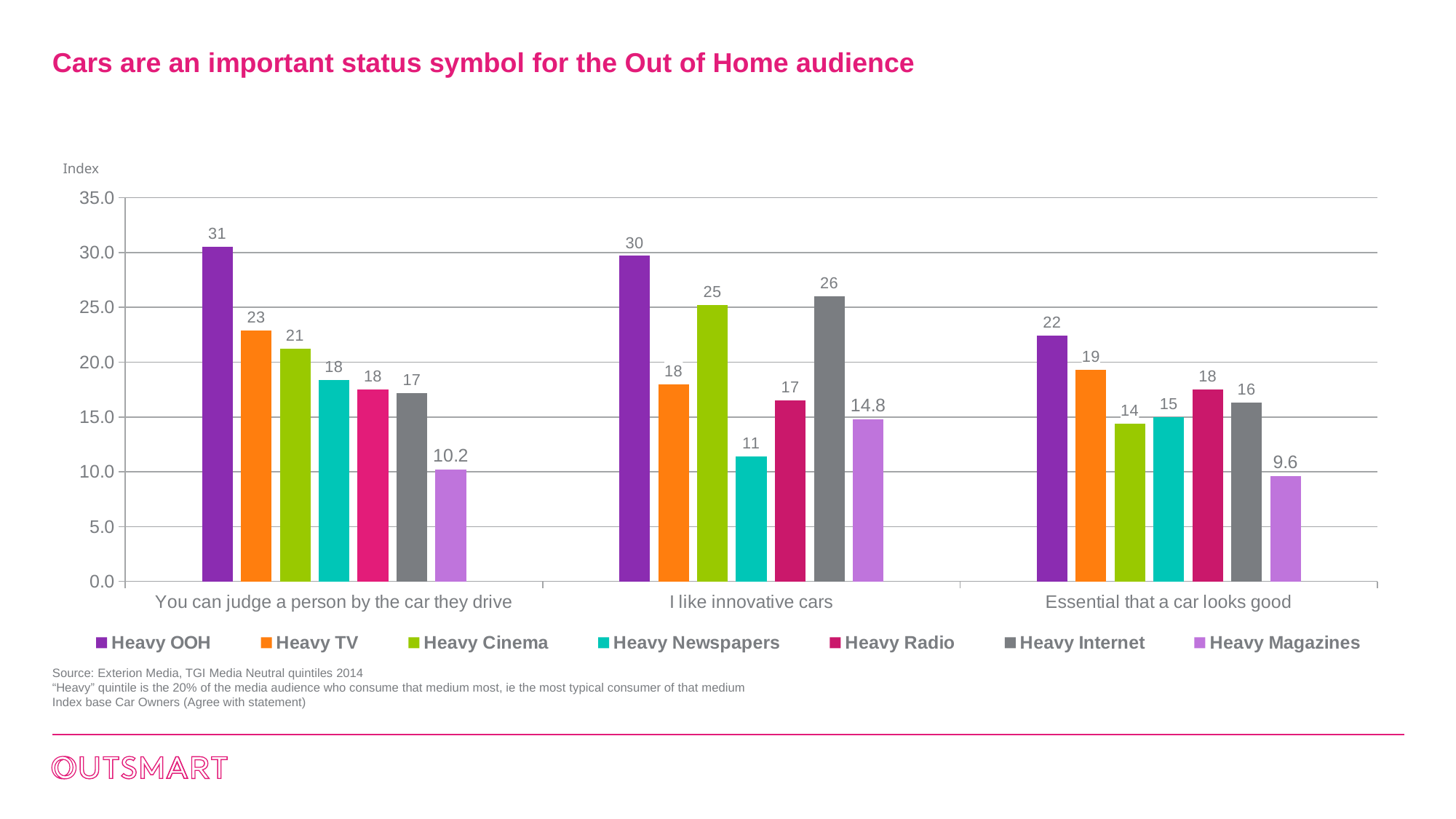
Is the Heavy Magazines value for "Essential that a car looks good" greater or less than 10.0? less What is the difference between the Heavy OOH and Heavy TV index values for "Essential that a car looks good"? 3 How many statement categories are shown on the x axis? 3 Which series has the lowest index for "I like innovative cars"? Heavy Newspapers What kind of chart is shown on the slide? Bar chart For "I like innovative cars", which is larger: Heavy Cinema or Heavy Internet? Heavy Internet What is the Heavy Magazines index for "I like innovative cars"? 14.8 What is the Heavy Internet index for "Essential that a car looks good"? 16 Which series has the highest index for "You can judge a person by the car they drive"? Heavy OOH What is the Heavy OOH index for "You can judge a person by the car they drive"? 31 What is the label on the y axis of the chart? Index How many series does the legend list? 7